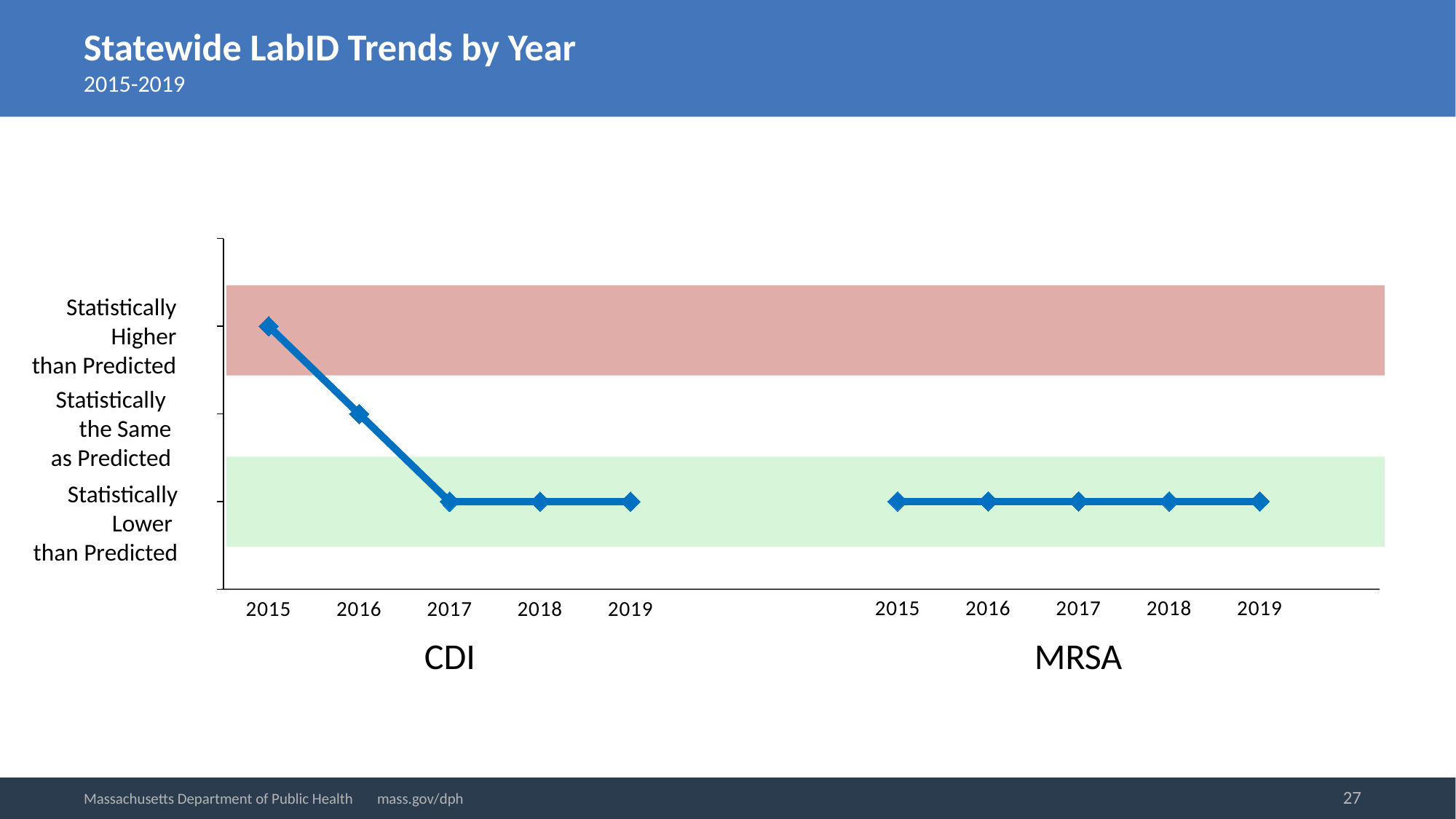
What kind of chart is shown on the slide? line chart How many years are plotted for MRSA? 5 For CDI, what category does the 2015 point fall in? Statistically Higher than Predicted What is the title of the slide's chart? Statewide LabID Trends by Year Which CDI year has the highest point on the chart? 2015 For CDI, what category does the 2019 point fall in? Statistically Lower than Predicted For MRSA, what category does the 2018 point fall in? Statistically Lower than Predicted How many years are plotted for CDI? 5 For CDI, what category does the 2016 point fall in? Statistically the Same as Predicted Does the CDI line rise or fall from 2015 to 2017? fall For MRSA, what category does the 2015 point fall in? Statistically Lower than Predicted Does the MRSA line rise, fall, or stay flat from 2015 to 2019? stay flat